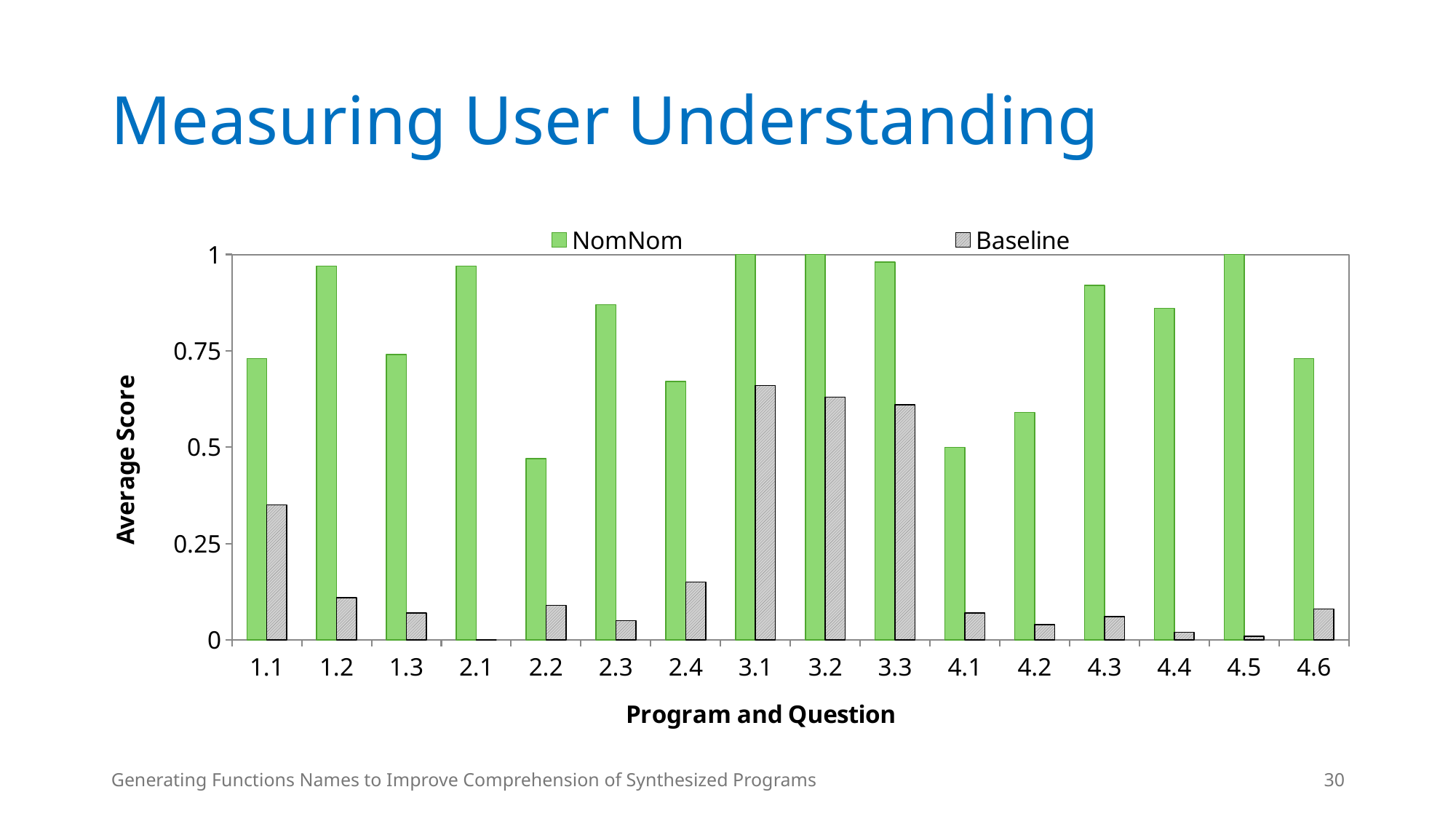
What is the NomNom value for 3.1? 1 Which category has the lowest NomNom value? 2.2 For category 1.1, which series has the larger value, NomNom or Baseline? NomNom Which category has the lowest Baseline value? 2.1 Is the NomNom value for 2.4 greater or less than 0.75? less How many program-and-question categories are shown on the x axis? 16 How many series does the legend list? 2 What kind of chart is shown on the slide? bar chart Is the Baseline value for 3.2 greater or less than 0.5? greater Is the NomNom value for 2.2 greater or less than 0.5? less What is the title of the y axis? Average Score